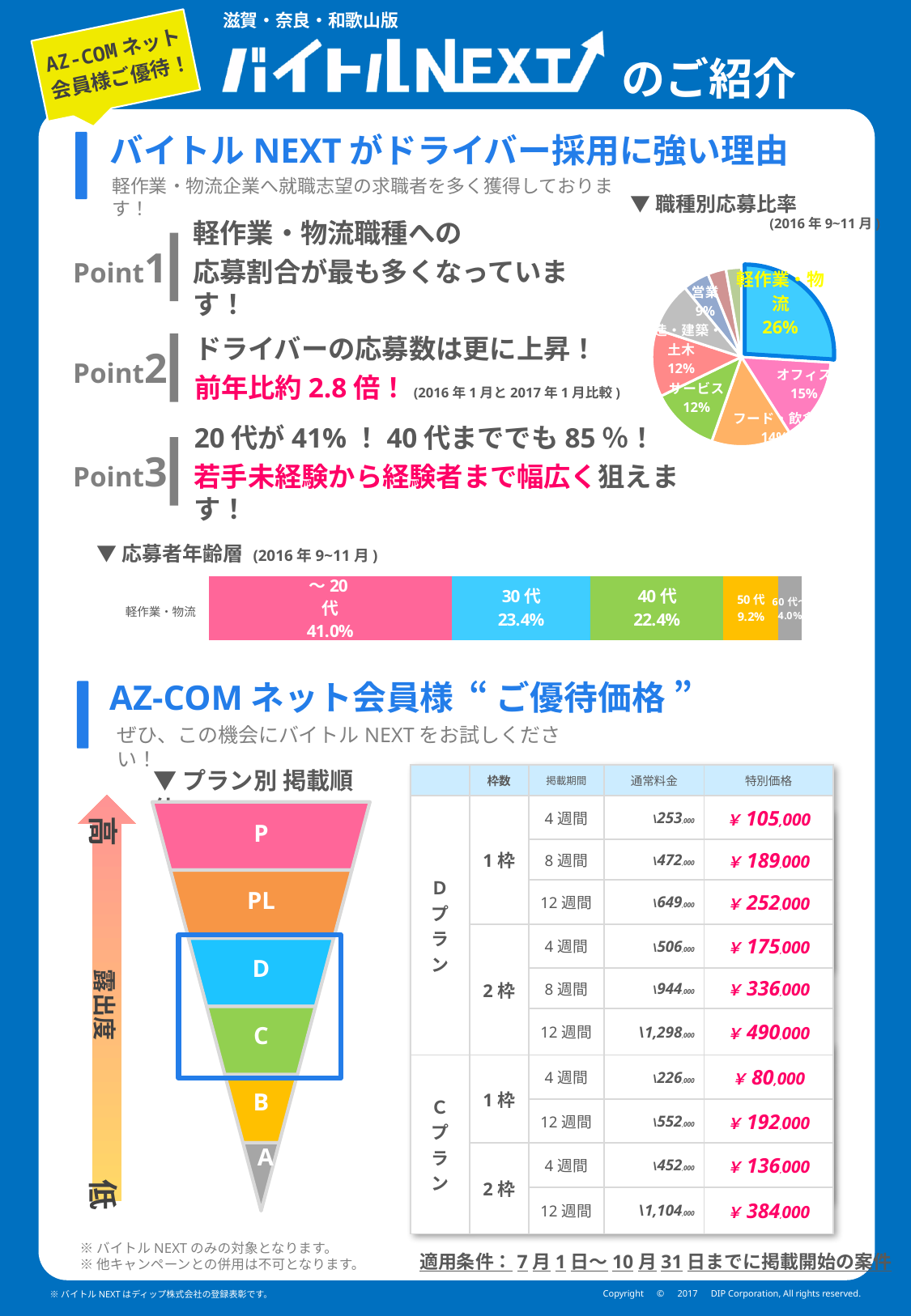
In the pie chart titled 職種別応募比率, which category has the largest share? 軽作業・物流 In the stacked bar chart titled 応募者年齢層, what is the difference between the values for 30代 and 40代? 1.0% In the stacked bar chart titled 応募者年齢層, which age group has the smallest value? 60代～ In the pie chart titled 職種別応募比率, what is the value for 軽作業・物流? 26% In the stacked bar chart titled 応募者年齢層, which age group has the largest value? ～20代 How many age-group segments are shown in the stacked bar chart titled 応募者年齢層? 5 In the pie chart titled 職種別応募比率, what is the value for オフィス? 15% In the pie chart titled 職種別応募比率, how much larger is the share of 軽作業・物流 than オフィス? 11% In the pie chart titled 職種別応募比率, which is larger, サービス or 営業? サービス In the stacked bar chart titled 応募者年齢層, what is the value for 30代? 23.4% What kind of chart is the 職種別応募比率 chart? pie chart In the pie chart titled 職種別応募比率, what is the value for 営業? 9%